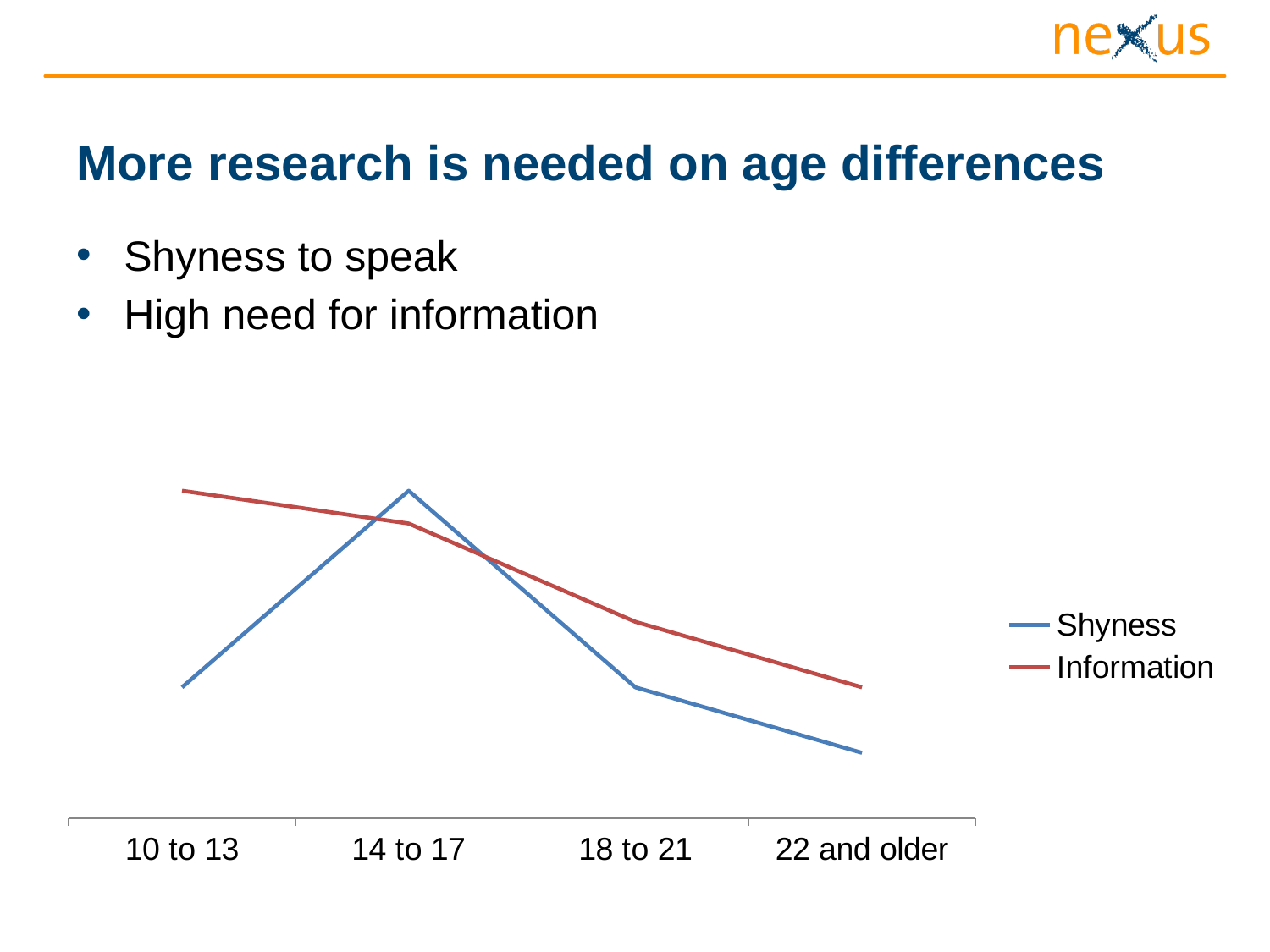
For which age group is the Shyness line at its highest? 14 to 17 For which age group is the Information line at its highest? 10 to 13 Does the Information line rise or fall as age increases along the x axis? fall At the 14 to 17 age group, which series has the higher value, Shyness or Information? Shyness What kind of chart is shown on the slide? line chart At the 10 to 13 age group, which series has the higher value, Shyness or Information? Information How many series does the legend list? 2 At the 22 and older age group, which series has the higher value, Shyness or Information? Information How many age categories are shown on the x axis? 4 For which age group is the Information line at its lowest? 22 and older Which colour is used for the Shyness series in the legend? blue For which age group is the Shyness line at its lowest? 22 and older